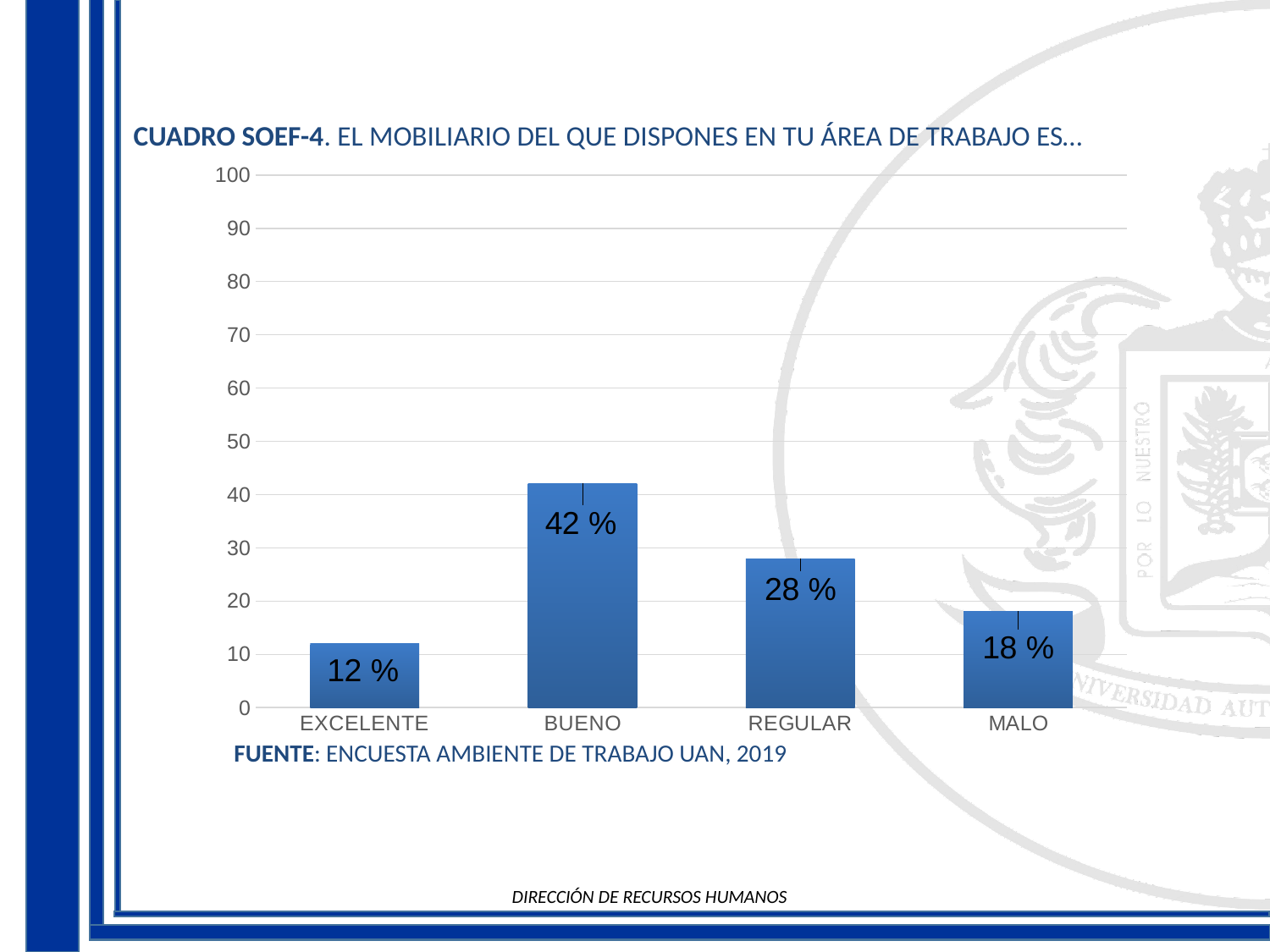
Is the value for BUENO greater or less than 40? greater What is the value for EXCELENTE? 12 % What kind of chart is shown on the slide? bar chart What is the value for BUENO? 42 % Which is larger, the value for REGULAR or the value for MALO? REGULAR Which category has the lowest value? EXCELENTE What is the value for MALO? 18 % How many categories are shown on the x axis? 4 What is the difference between the values for BUENO and REGULAR? 14 % What is the value for REGULAR? 28 % Which category has the highest value? BUENO What source is cited below the chart? ENCUESTA AMBIENTE DE TRABAJO UAN, 2019